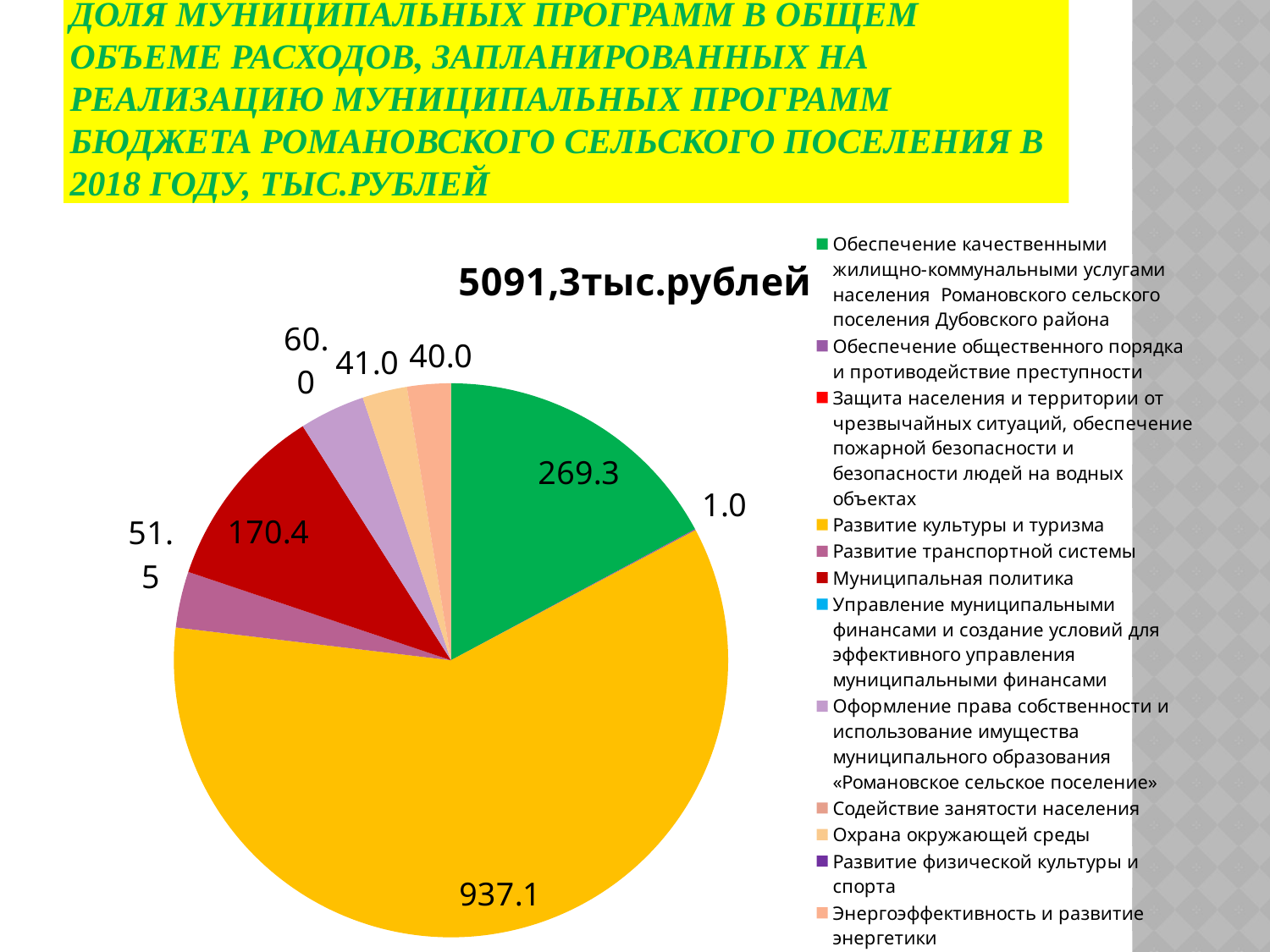
Which legend category corresponds to the largest (yellow) slice of the pie chart? Развитие культуры и туризма What is the value of the slice for Развитие транспортной системы? 51.5 What is the value of the largest slice of the pie chart? 937.1 What kind of chart is shown on the slide? pie chart What is the difference between the largest slice (937.1) and the green slice (269.3)? 667.8 What is the title shown above the pie chart? 5091,3тыс.рублей What is the value of the light purple slice (Оформление права собственности и использование имущества)? 60.0 What is the value of the dark red slice (Муниципальная политика)? 170.4 How many entries does the legend of the pie chart list? 12 Which is larger: the green slice (269.3) or the dark red slice (170.4)? the green slice (269.3) What is the smallest value labelled on the pie chart? 1.0 What is the value of the green slice (Обеспечение качественными жилищно-коммунальными услугами населения)? 269.3